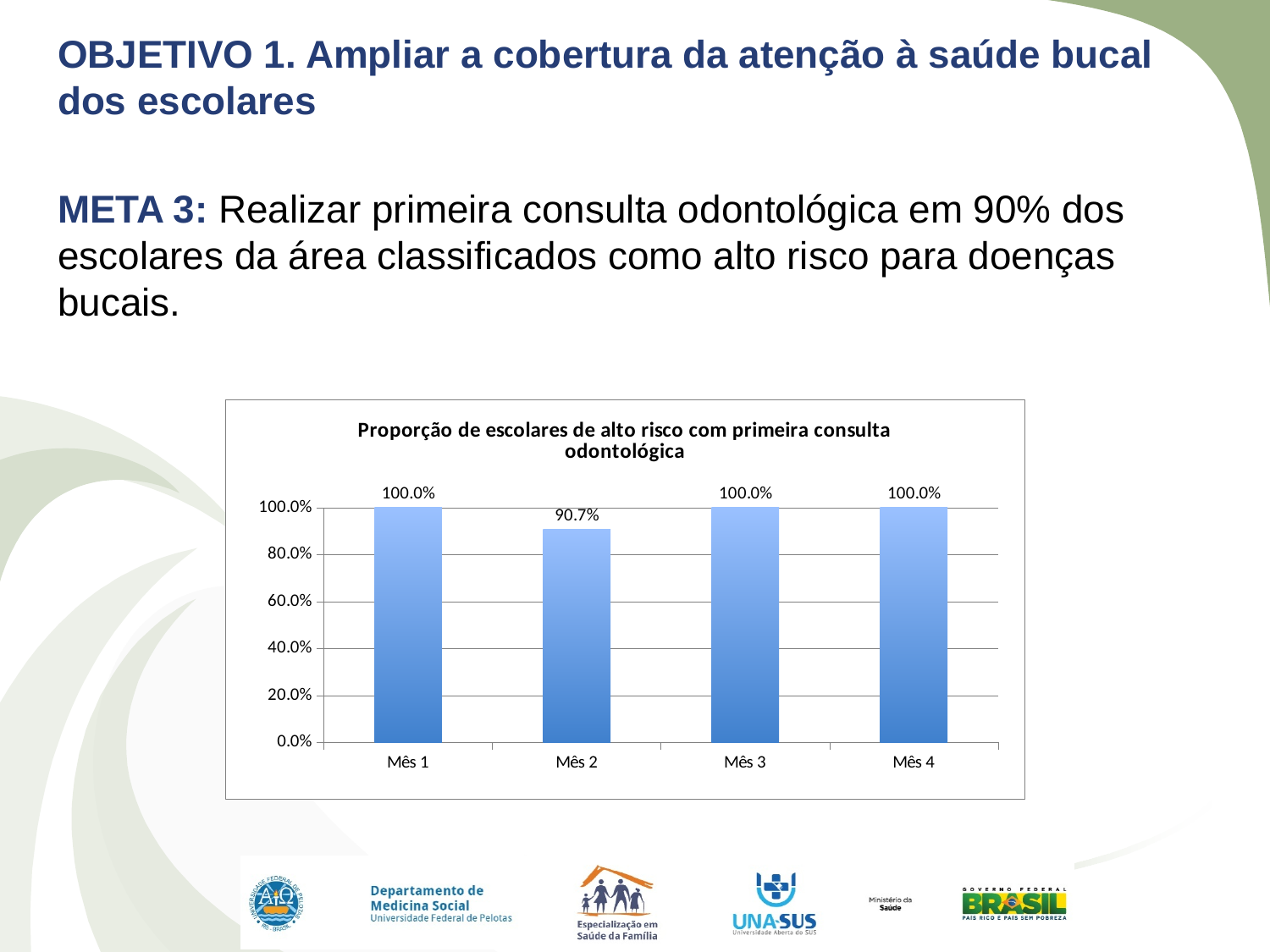
What is the highest value shown on the y axis? 100.0% How many months have a value of 100.0%? 3 What is the value for Mês 4? 100.0% How many months are shown on the x axis? 4 Which is larger, the value for Mês 2 or the value for Mês 3? Mês 3 What is the value for Mês 2? 90.7% What kind of chart is shown? bar chart Is the value for Mês 2 greater or less than 80.0%? greater Which month has the lowest value? Mês 2 What is the difference between the values for Mês 1 and Mês 2? 9.3% What is the value for Mês 1? 100.0% What is the title of the chart? Proporção de escolares de alto risco com primeira consulta odontológica